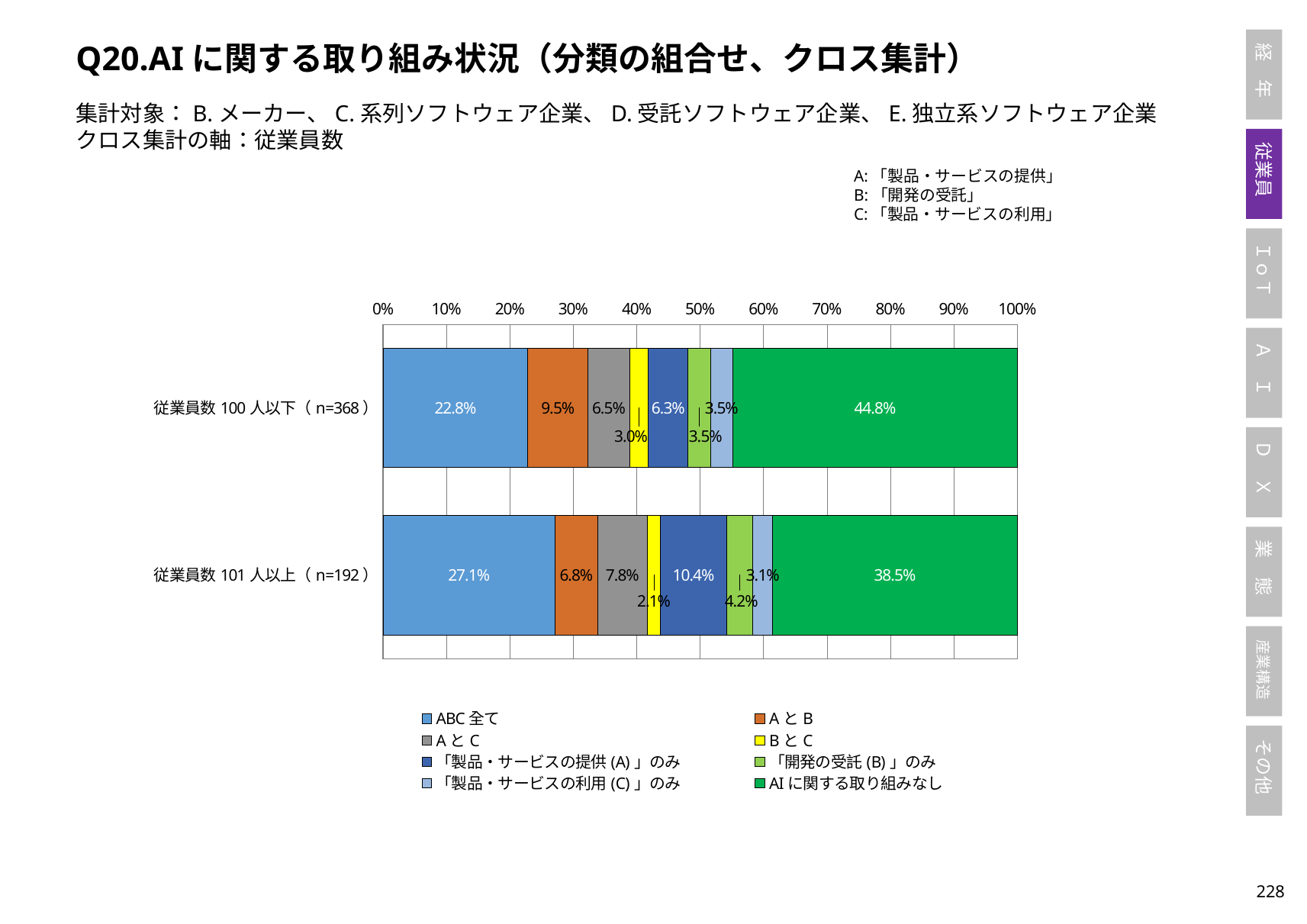
What is the sample size (n) for the 従業員数 101 人以上 group? 192 What is the value of 「AI に関する取り組みなし」 for 従業員数 101 人以上 (n=192)? 38.5% How many series does the legend list? 8 Which group has the larger value for 「A と B」: 従業員数 100 人以下 or 従業員数 101 人以上? 従業員数 100 人以下 How many categories (employee-size groups) are plotted on the chart? 2 What is the difference in 「ABC 全て」 between 従業員数 101 人以上 and 従業員数 100 人以下? 4.3% Which series has the smallest share for 従業員数 101 人以上 (n=192)? B と C What type of chart is shown on the slide? Stacked bar chart What is the value of 「B と C」 for 従業員数 100 人以下 (n=368)? 3.0% Which series has the largest share for 従業員数 100 人以下 (n=368)? AI に関する取り組みなし What is the value of 「製品・サービスの提供 (A)」のみ for 従業員数 101 人以上 (n=192)? 10.4% What is the value of 「ABC 全て」 for 従業員数 100 人以下 (n=368)? 22.8%